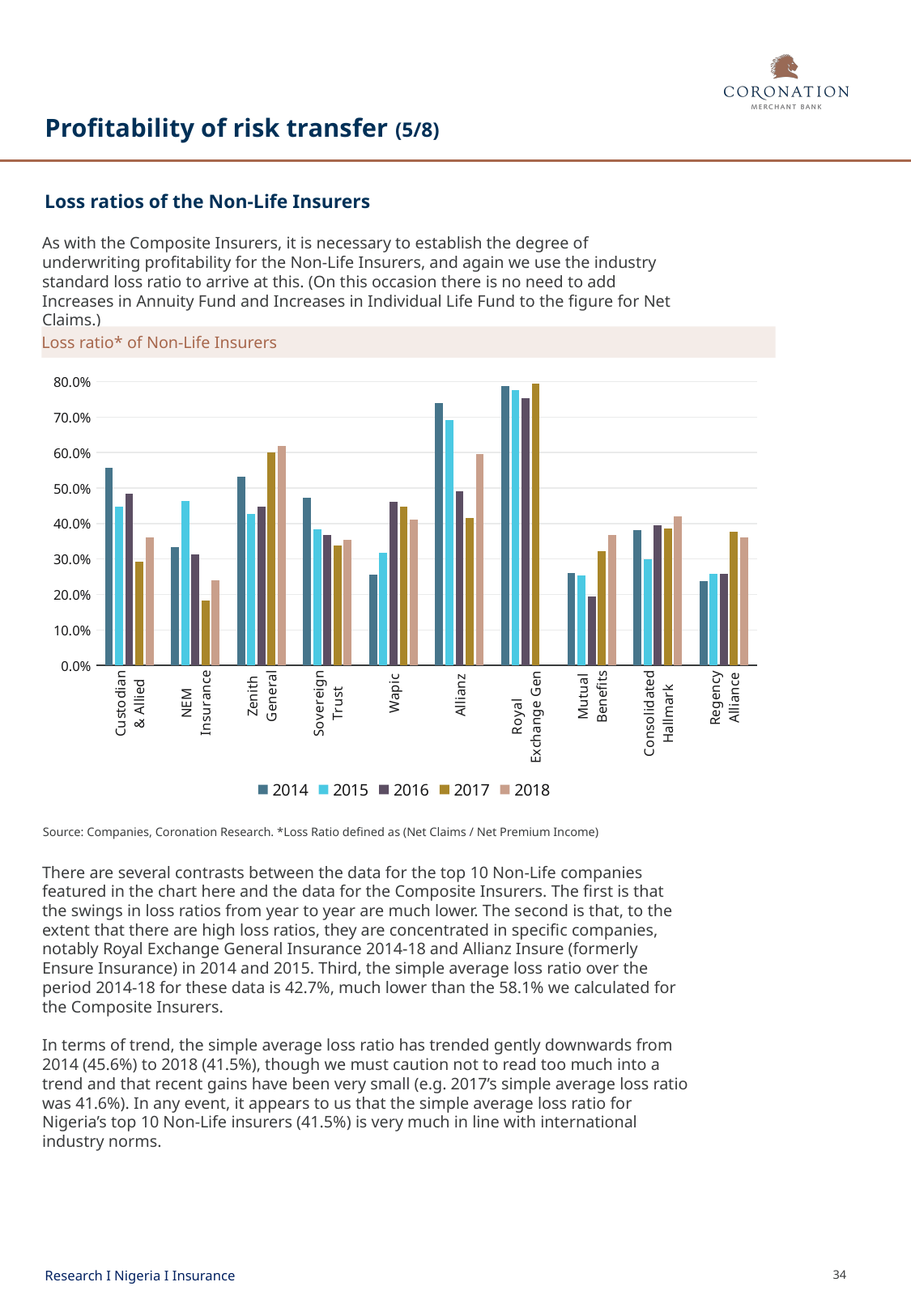
Is the 2014 loss ratio for Wapic greater or less than 30.0%? less How many series does the chart legend list? 5 Which company has the lowest 2017 loss ratio? NEM Insurance What is the title of the chart? Loss ratio* of Non-Life Insurers For Allianz, which year has the larger loss ratio, 2014 or 2018? 2014 How many insurance companies are shown on the x axis of the chart? 10 Is the 2017 loss ratio for NEM Insurance greater or less than 20.0%? less Which years are listed in the chart legend? 2014, 2015, 2016, 2017, 2018 Is the 2014 loss ratio for Royal Exchange Gen greater or less than 70.0%? greater Which company has the highest 2014 loss ratio? Royal Exchange Gen What kind of chart is shown on the slide? bar chart